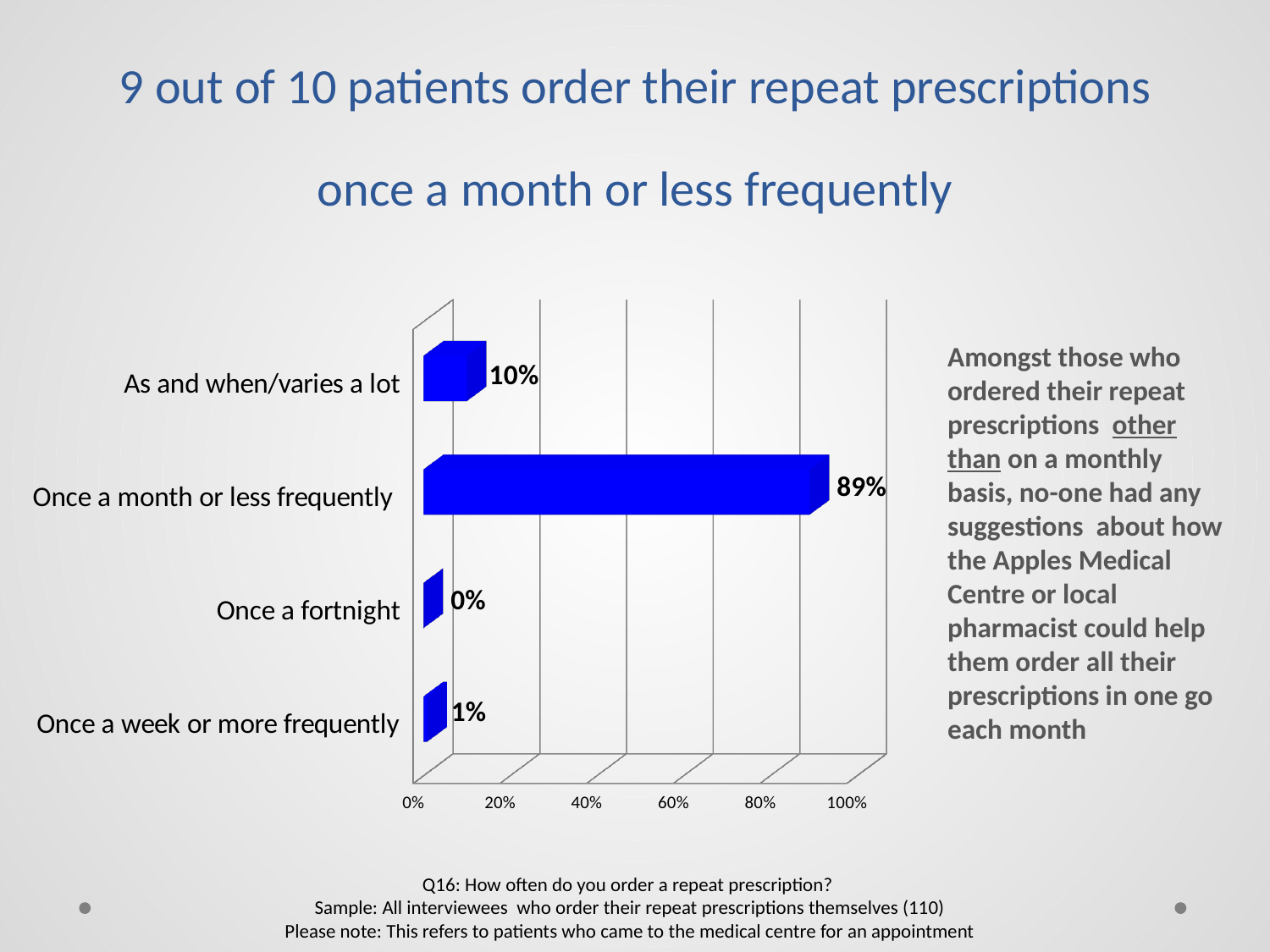
What is the value for 'Once a fortnight'? 0% Which category has the highest value? Once a month or less frequently What percentage of patients order their repeat prescriptions once a month or less frequently? 89% How many categories are shown in the chart? 4 What is the difference between the values for 'Once a month or less frequently' and 'As and when/varies a lot'? 79% Which category has the lowest value? Once a fortnight What kind of chart is shown on the slide? Bar chart Is the value for 'Once a month or less frequently' greater or less than 80%? greater What is the value for 'As and when/varies a lot'? 10% What is the value for 'Once a week or more frequently'? 1% Which is larger: the value for 'As and when/varies a lot' or the value for 'Once a week or more frequently'? As and when/varies a lot What is the highest value shown on the chart's horizontal axis? 100%